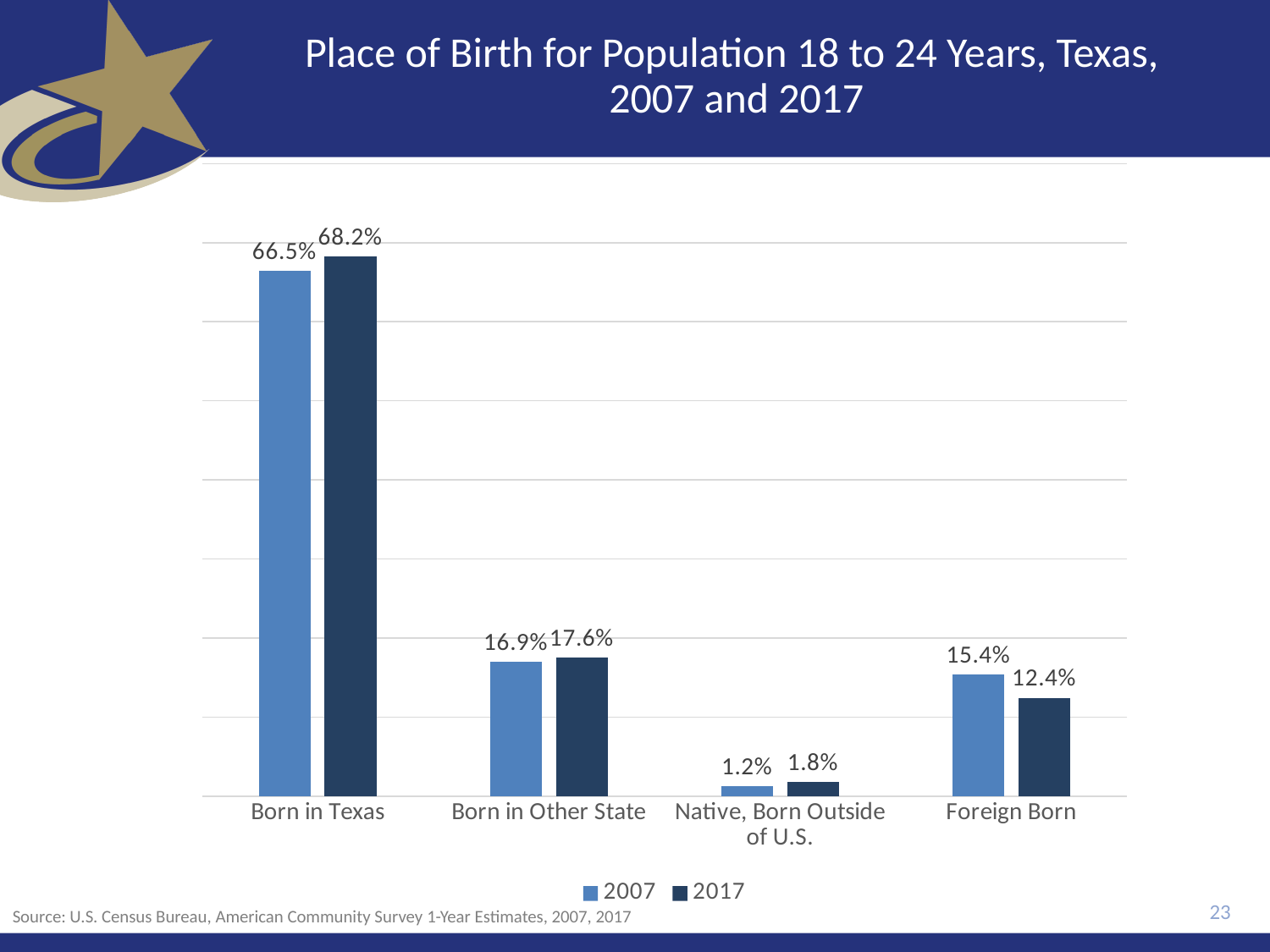
What is the difference between the 2007 and 2017 values for Foreign Born? 3.0% Which category has the highest 2017 value? Born in Texas How many categories are shown on the x axis? 4 Which category has the lowest 2007 value? Native, Born Outside of U.S. What is the 2007 value for Foreign Born? 15.4% What kind of chart is shown on the slide? Bar chart What is the 2017 value for Born in Texas? 68.2% How many series does the legend list? 2 What is the difference between the 2017 and 2007 values for Born in Texas? 1.7% Which is larger for Born in Other State, the 2007 value or the 2017 value? 2017 What is the 2007 value for Native, Born Outside of U.S.? 1.2% What is the title of the chart? Place of Birth for Population 18 to 24 Years, Texas, 2007 and 2017